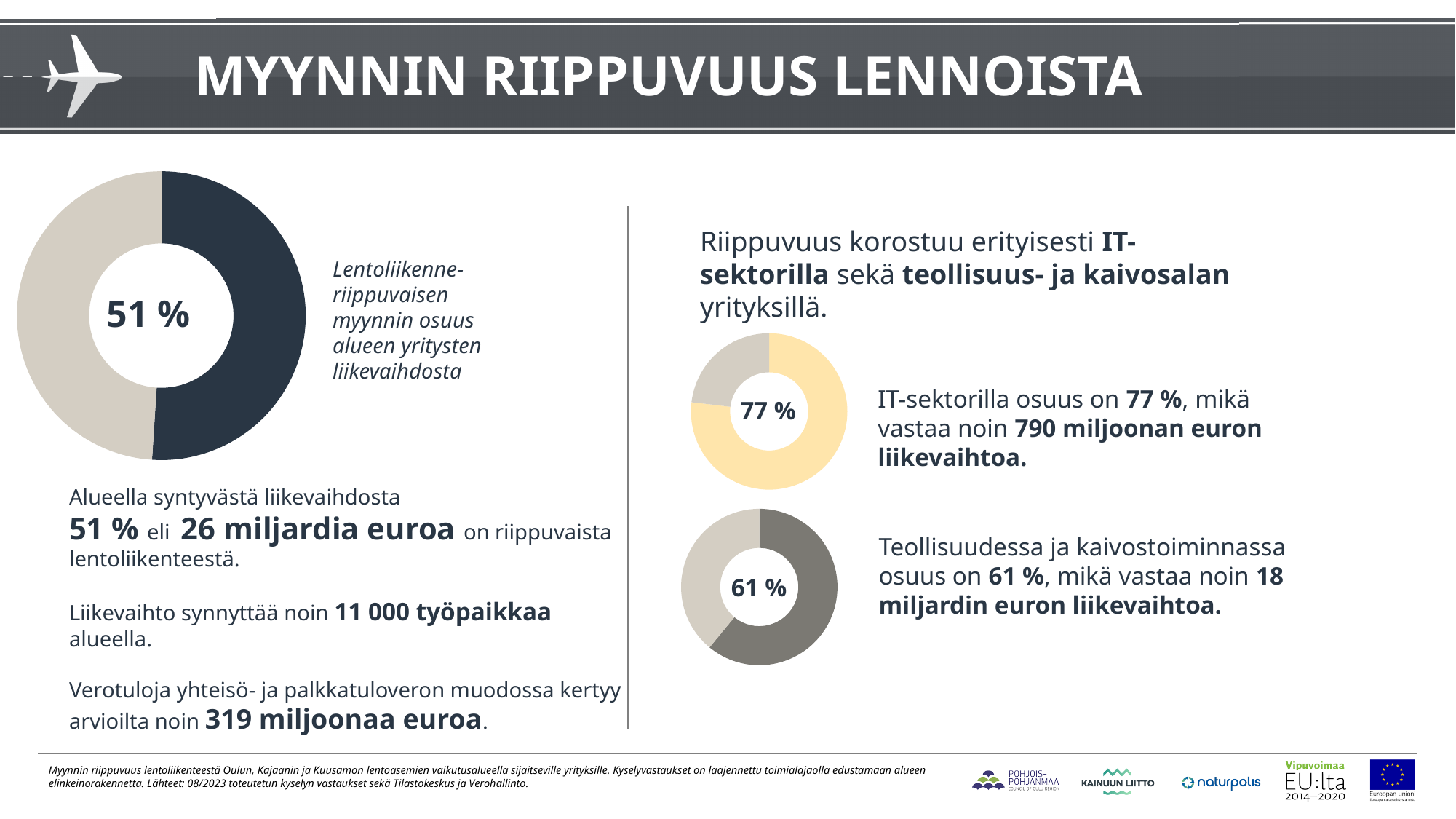
In the large donut chart on the left, is the dark-coloured share greater or less than 50%? greater Which of the three donut charts on the slide shows the lowest percentage? The large chart on the left (51 %) What is the difference in percentage points between the IT sector donut chart and the industry and mining donut chart? 16 percentage points How many donut charts are shown on the slide? 3 In the upper donut chart on the right (IT sector), what percentage is shown in the centre? 77 % What kind of chart is the large chart on the left side of the slide? Donut (pie) chart Which of the two small donut charts on the right shows the larger share: the IT sector chart or the industry and mining chart? IT sector chart In the upper donut chart on the right, what colour is the 77 % segment? Yellow In the large donut chart on the left, what percentage is shown in the centre? 51 % Which of the three donut charts on the slide shows the highest percentage? The IT sector chart (77 %) In the lower donut chart on the right (industry and mining), what percentage is shown in the centre? 61 % In the large donut chart on the left, what share of the ring is not covered by the dark 51 % segment? 49 %